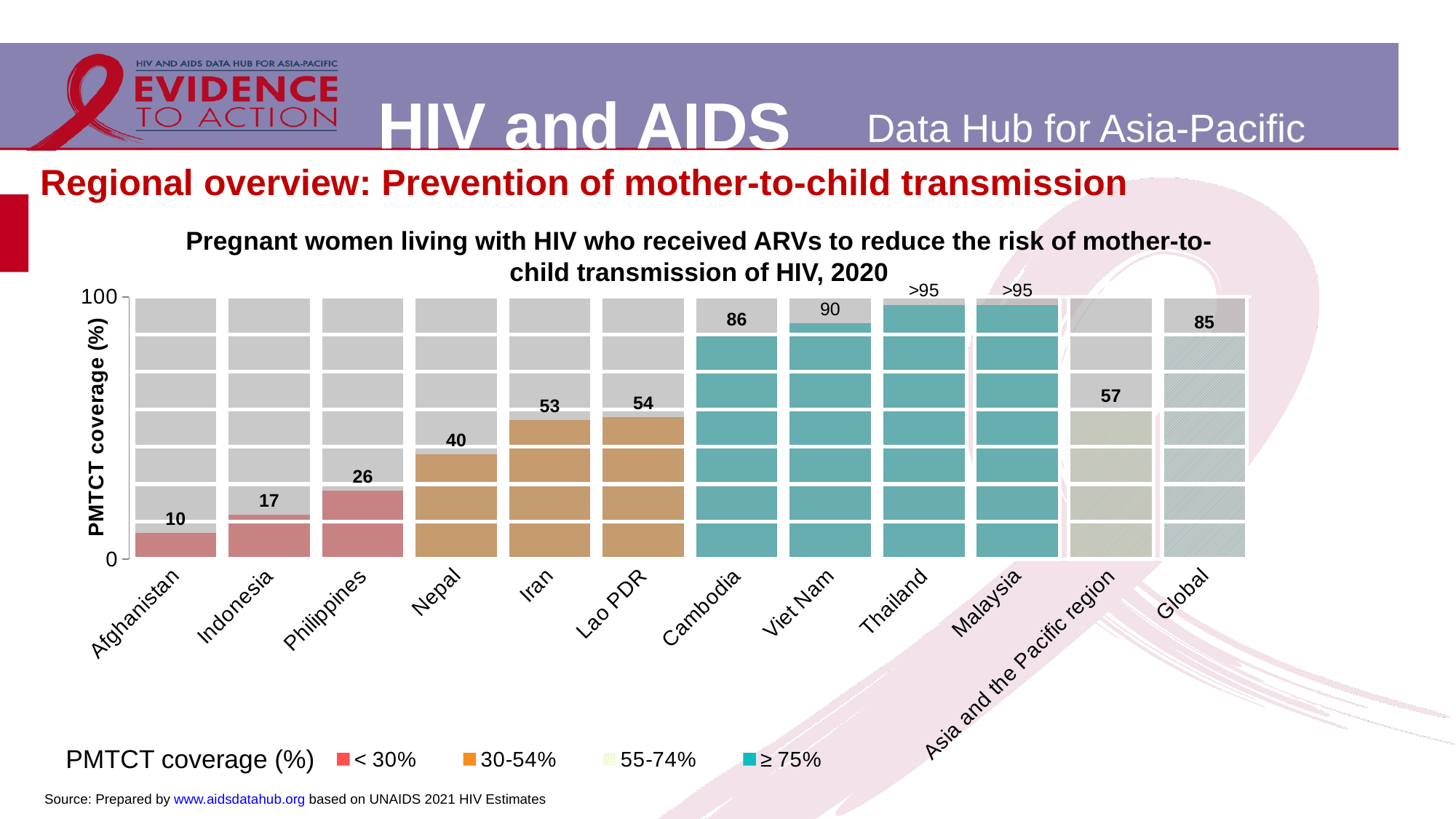
What value is shown for Asia and the Pacific region? 57 What is the PMTCT coverage value shown for Nepal? 40 What is the difference between the values for Global and Asia and the Pacific region? 28 What kind of chart is shown on the slide? bar chart Which category has the lowest PMTCT coverage? Afghanistan How many entries does the legend list? 4 Which has a higher value, Philippines or Nepal? Nepal How many categories are shown on the x axis? 12 What is the difference between the values for Cambodia and Nepal? 46 What is the value shown for Global? 85 What value is shown for Thailand? >95 Is the value for Indonesia greater or less than 50? less